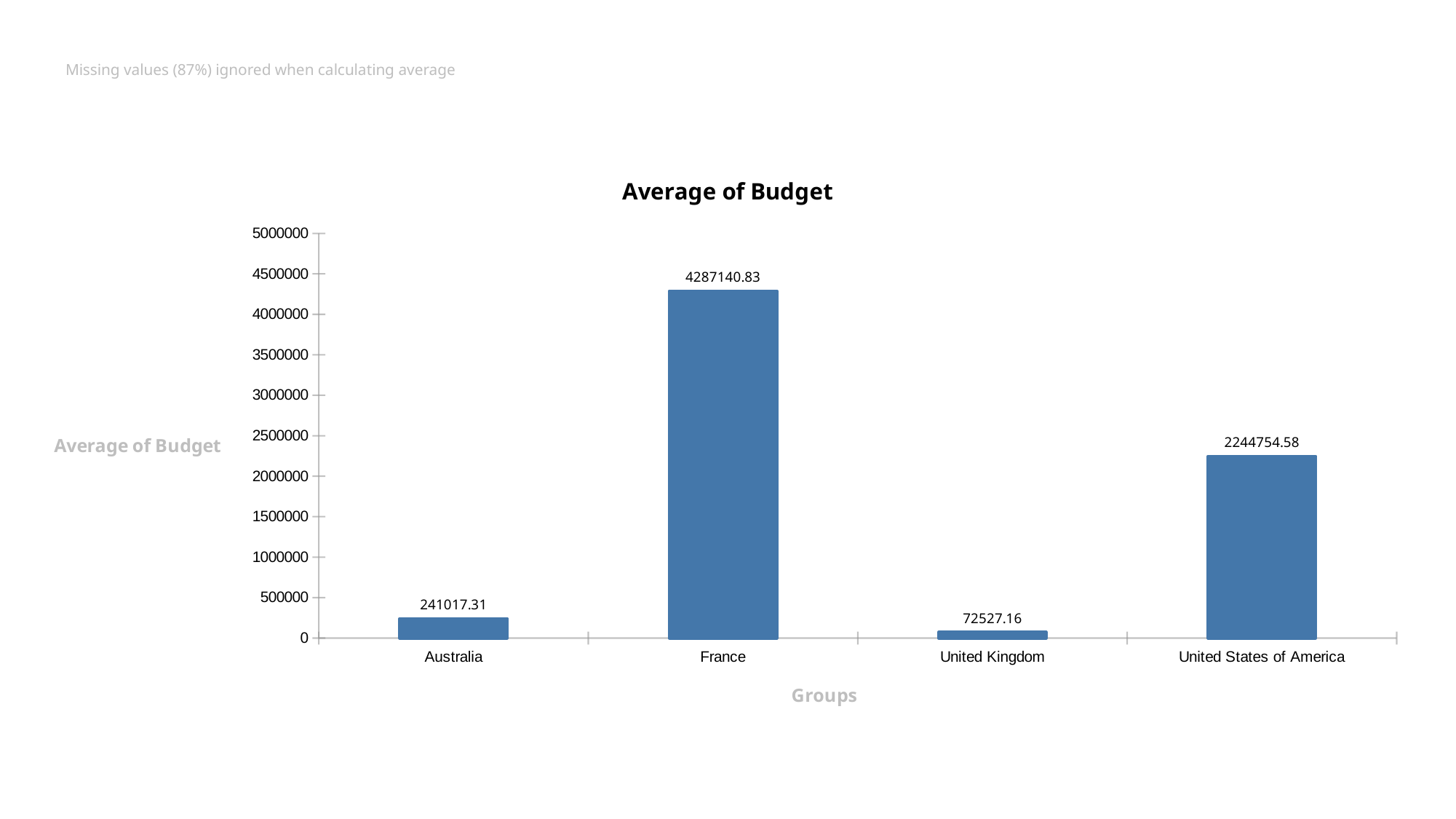
Which has a larger average budget, Australia or the United Kingdom? Australia What is the average budget for the United States of America? 2244754.58 How many groups are shown on the x axis? 4 What is the difference between the average budget of France and the United States of America? 2042386.25 What is the average budget for France? 4287140.83 What is the average budget for the United Kingdom? 72527.16 What is the title of the chart? Average of Budget Which group has the lowest average budget? United Kingdom What is the average budget for Australia? 241017.31 What kind of chart is shown on the slide? bar chart Is the value for the United States of America greater or less than 2000000? greater Which group has the highest average budget? France